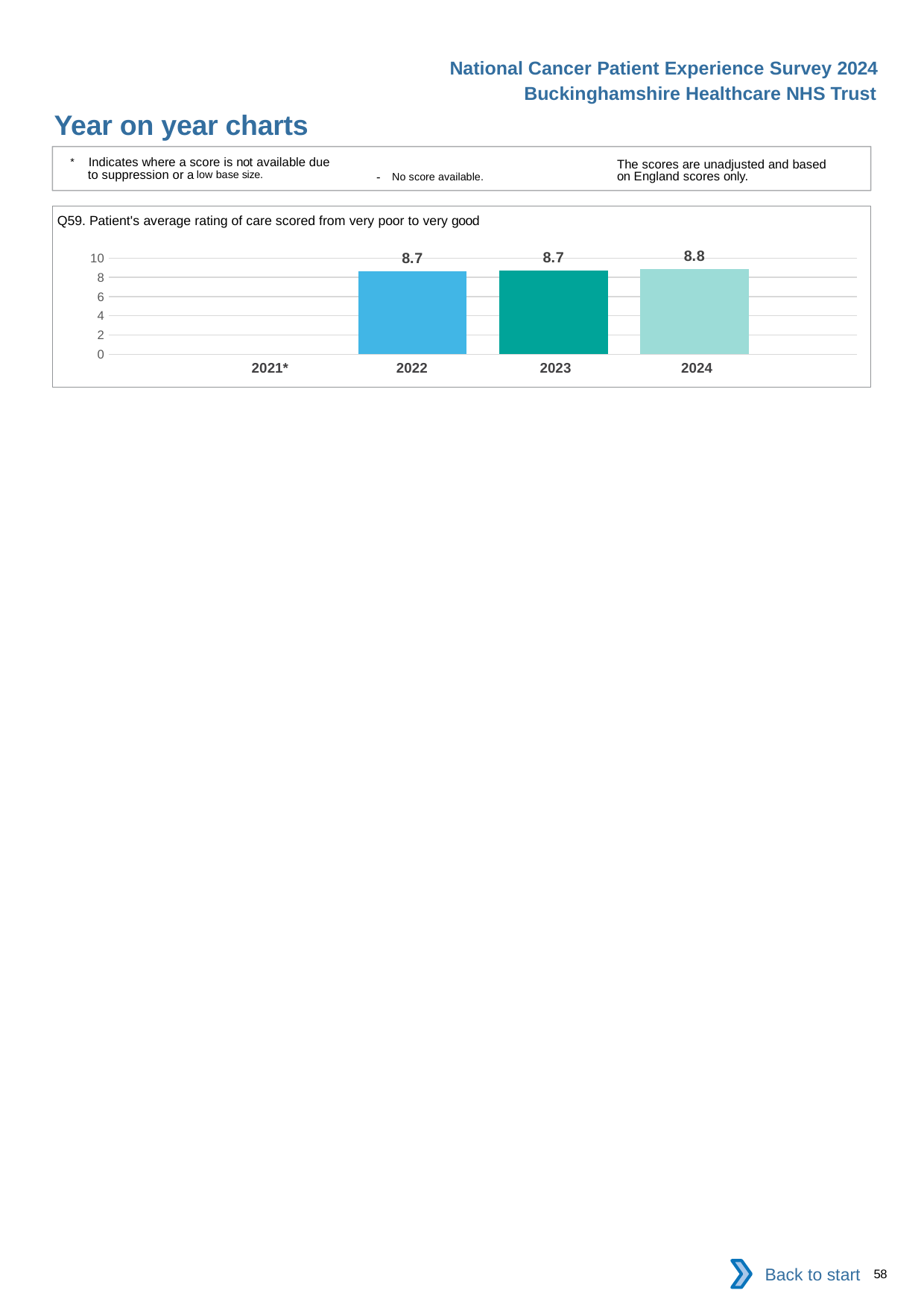
Do the values rise or fall from 2022 to 2024? Rise How many year categories are shown on the x axis? 4 What is the maximum value shown on the y axis? 10 What is the difference between the values for 2024 and 2022? 0.1 Which year has the highest value? 2024 What is the value for 2022? 8.7 Which year has no bar plotted? 2021* What is the title of the chart? Q59. Patient's average rating of care scored from very poor to very good Is the value for 2024 greater or less than 8? greater What kind of chart is this? Bar chart What is the value for 2023? 8.7 What is the value for 2024? 8.8